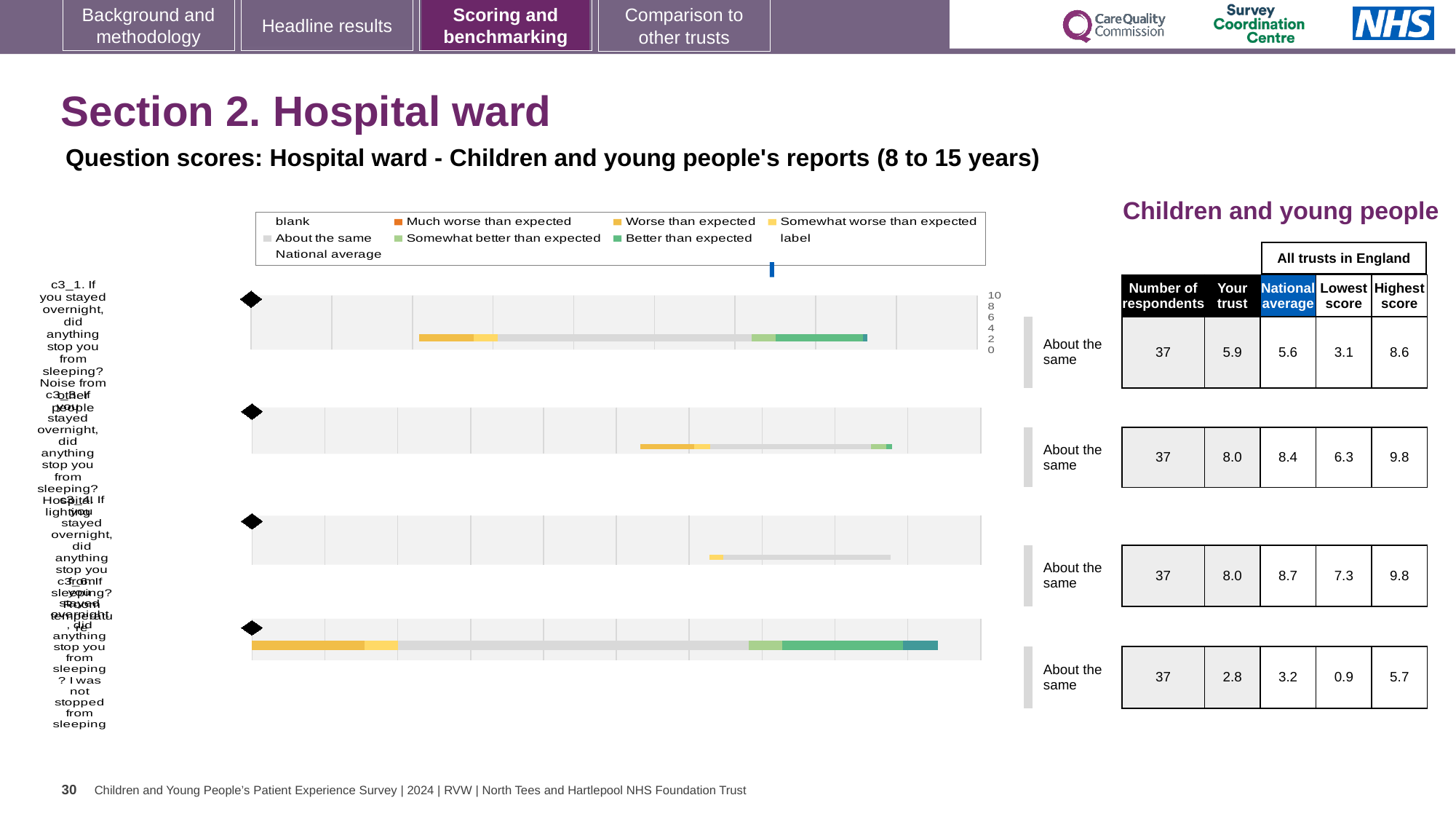
How many benchmark bar charts (question rows) are shown on the slide? 4 What benchmark category label is shown next to each of the four charts? About the same For the second chart, is the 'Your trust' score (8.0) larger or smaller than the national average (8.4)? smaller For the fourth (bottom) chart, what is the highest score across all trusts in England? 5.7 For the first chart (c3_1, noise from other people), what is the 'Your trust' score shown in the table? 5.9 What kind of chart is used for the benchmark rows on this slide? bar chart For the first chart (c3_1, noise from other people), what is the national average score shown in the table? 5.6 How many respondents are listed for each of the four charts? 37 Which of the four charts has the lowest 'Your trust' score in the table? the fourth (bottom) chart For the first chart (c3_1, noise from other people), what is the difference between the 'Your trust' score and the national average? 0.3 For the fourth (bottom) chart, what is the 'Your trust' score shown in the table? 2.8 For the fourth (bottom) chart, what is the difference between the highest and lowest scores across all trusts in England? 4.8